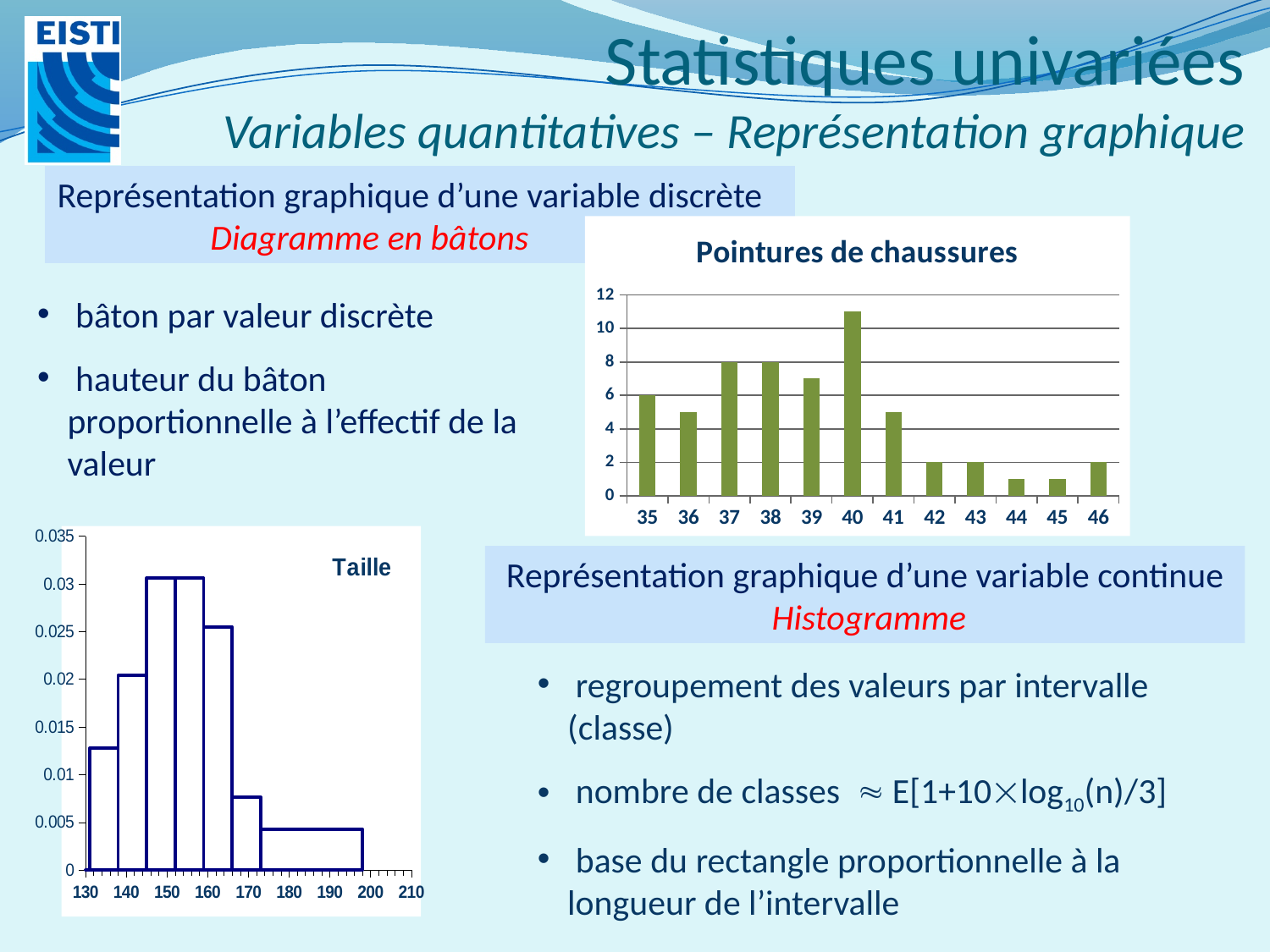
In the 'Pointures de chaussures' chart, what is the difference between the values for size 37 and size 42? 6 In the 'Pointures de chaussures' chart, what is the value for size 42? 2 In the 'Pointures de chaussures' chart, which shoe size has the highest count? 40 In the 'Pointures de chaussures' chart, what is the value for size 37? 8 In the 'Pointures de chaussures' chart, is the value for size 40 greater or less than 10? greater In the 'Taille' histogram, is the value for the 130-140 interval greater or less than 0.01? greater In the 'Pointures de chaussures' chart, what is the value for size 35? 6 What kind of chart is 'Pointures de chaussures'? bar chart In the 'Pointures de chaussures' chart, is the value for size 44 greater or less than 2? less How many shoe sizes are shown on the x axis of the 'Pointures de chaussures' chart? 12 In the 'Pointures de chaussures' chart, which is larger, the value for size 39 or the value for size 41? 39